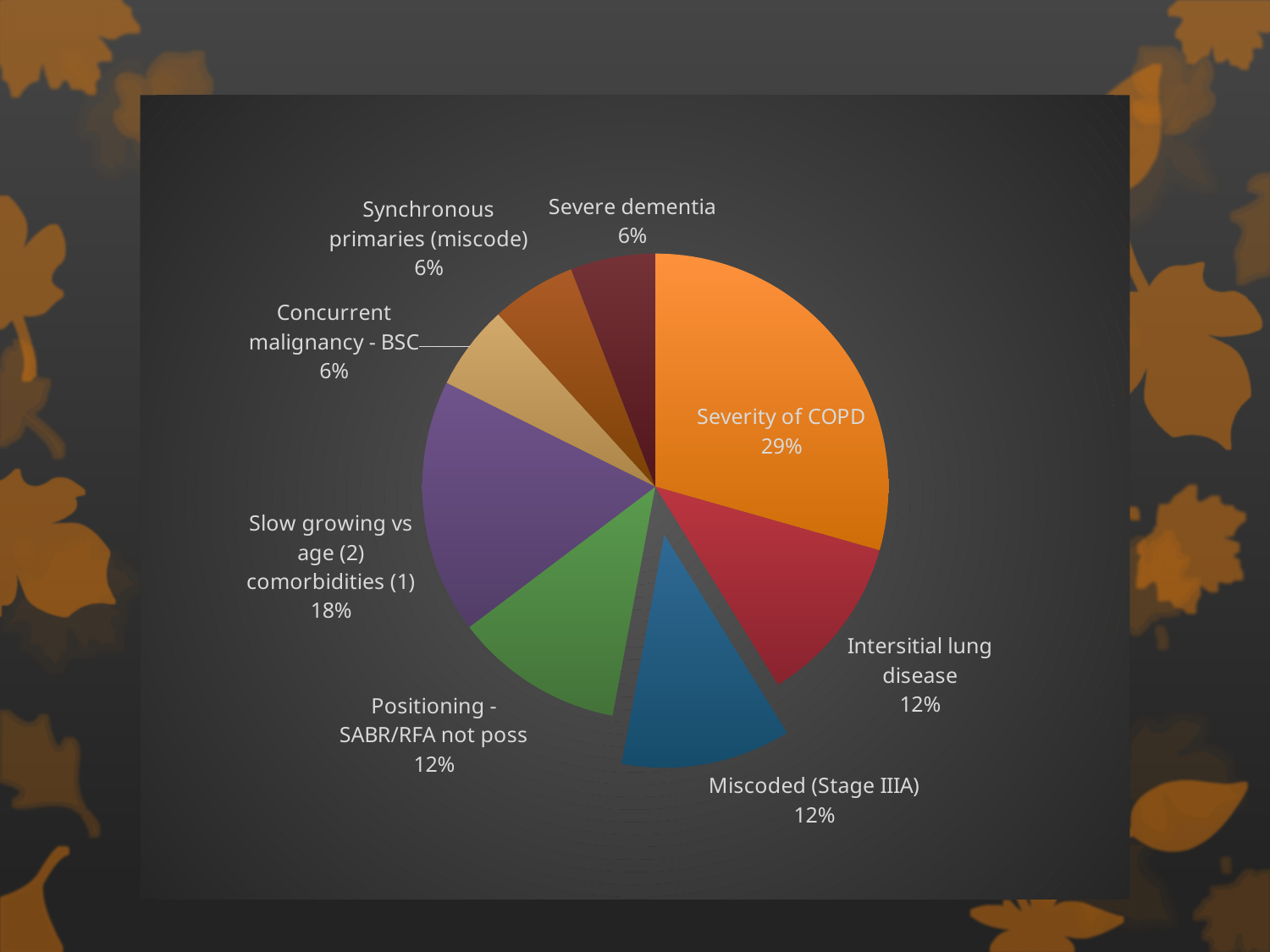
What is the difference in percentage points between Severity of COPD and Slow growing vs age (2) comorbidities (1)? 11 What share of the pie does Severity of COPD represent? 29% Which category has the largest slice of the pie? Severity of COPD What percentage is shown for Slow growing vs age (2) comorbidities (1)? 18% What percentage is shown for Severe dementia? 6% What percentage is shown for Miscoded (Stage IIIA)? 12% Which slice is pulled out (exploded) from the rest of the pie? Miscoded (Stage IIIA) What kind of chart is shown on the slide? Pie chart What is the difference in percentage points between Slow growing vs age (2) comorbidities (1) and Synchronous primaries (miscode)? 12 Which is larger, the slice for Positioning - SABR/RFA not poss or the slice for Concurrent malignancy - BSC? Positioning - SABR/RFA not poss How many slices does the pie chart have? 8 What percentage is shown for Intersitial lung disease? 12%